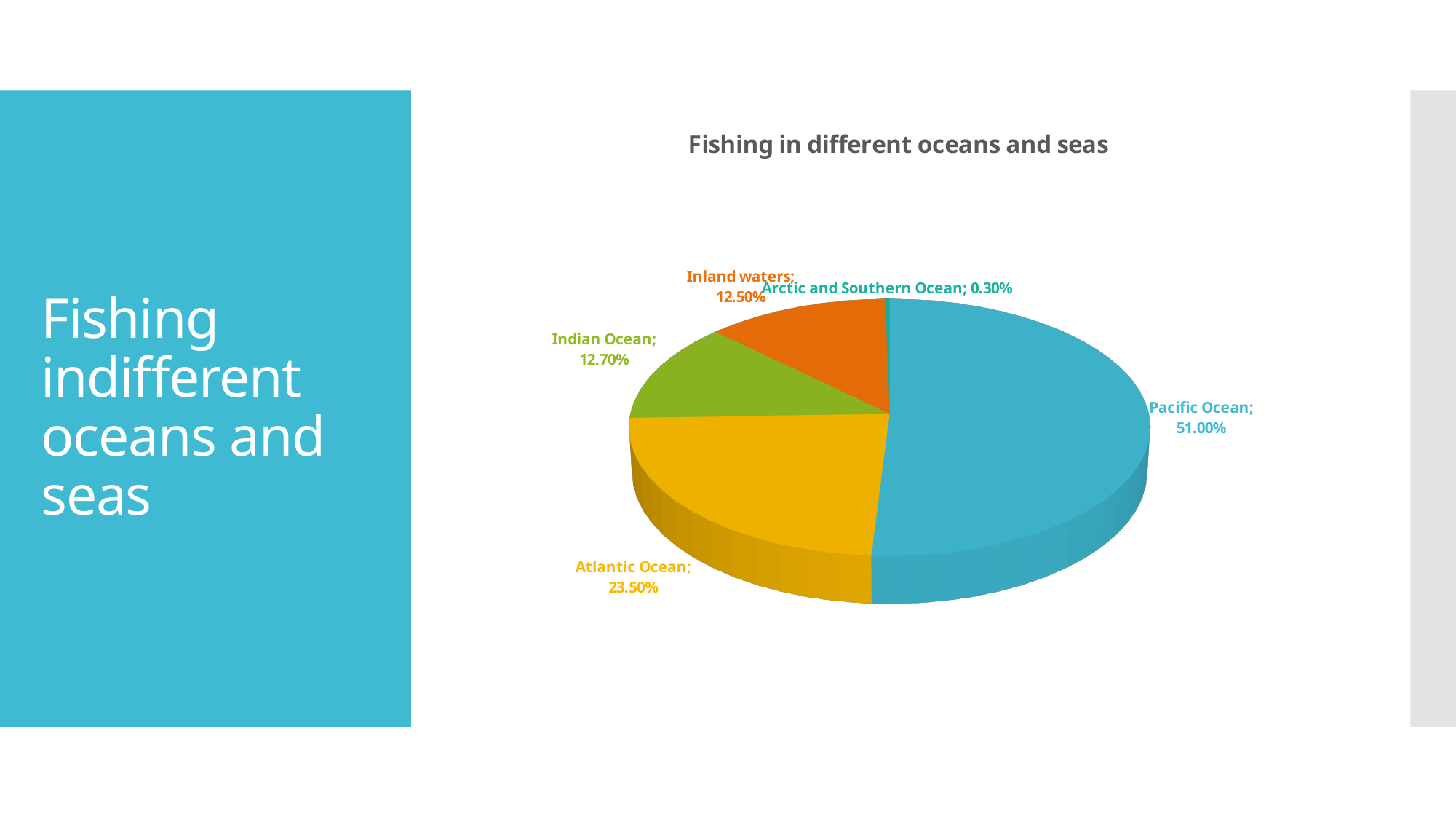
What is the title of the chart? Fishing in different oceans and seas What is the value shown for the Indian Ocean? 12.70% What share of the pie does the Pacific Ocean have? 51.00% What is the value shown for the Atlantic Ocean? 23.50% How many categories are shown in the pie chart? 5 Which category has the largest slice of the pie? Pacific Ocean What is the value shown for the Arctic and Southern Ocean? 0.30% What is the difference between the Pacific Ocean and Atlantic Ocean shares? 27.50% Which is larger, the Atlantic Ocean share or the Indian Ocean share? Atlantic Ocean What is the value shown for Inland waters? 12.50% What kind of chart is shown on the slide? Pie chart Which category has the smallest slice of the pie? Arctic and Southern Ocean